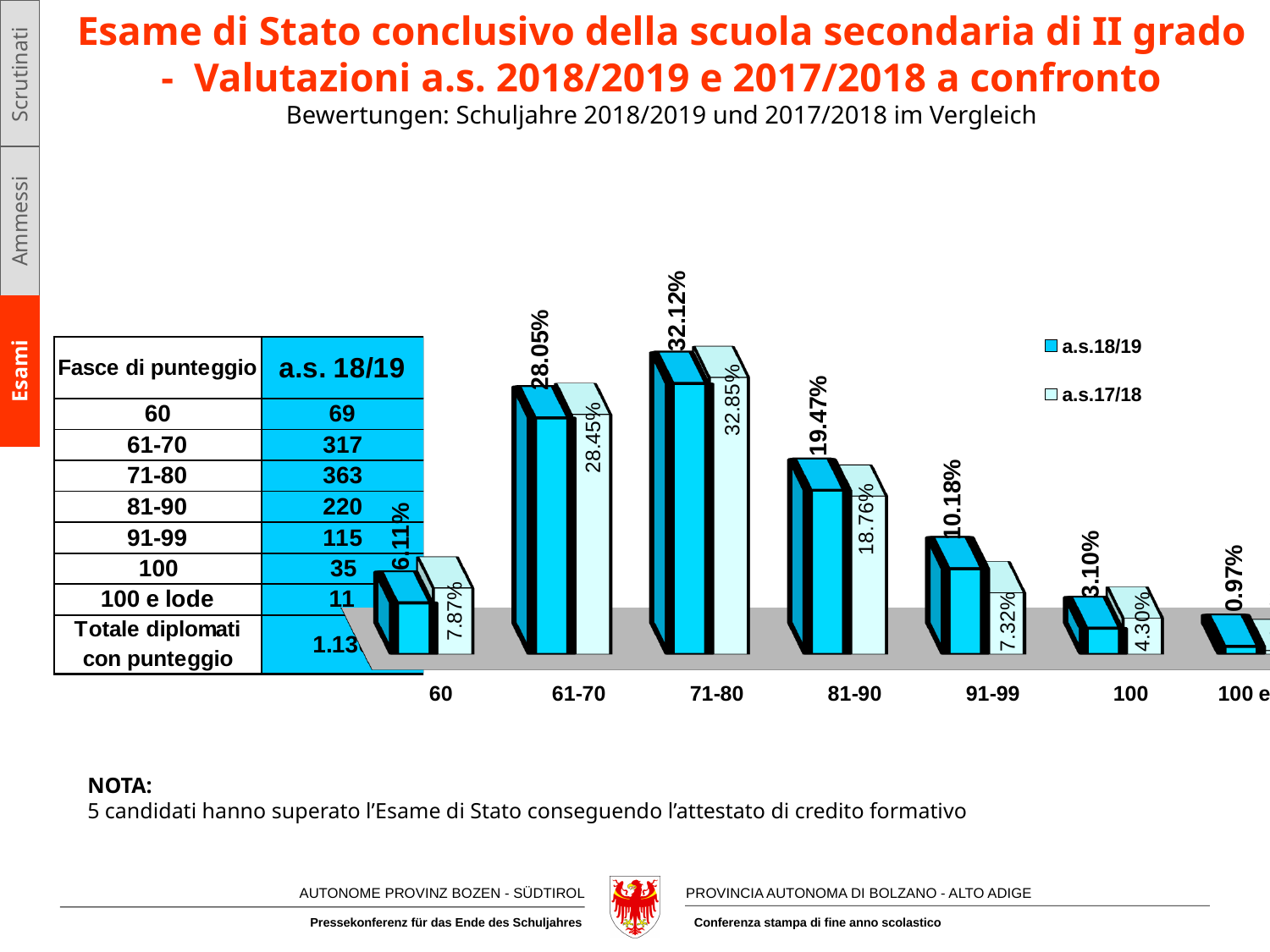
What is the difference between the a.s.18/19 and a.s.17/18 values for the 91-99 score band? 2.86% For the 60 score band, which series has the larger value, a.s.18/19 or a.s.17/18? a.s.17/18 What is the value for the 91-99 score band in the a.s.18/19 series? 10.18% What kind of chart is shown on the slide? bar chart What are the two series names shown in the chart legend? a.s.18/19 and a.s.17/18 What is the value for the 61-70 score band in the a.s.17/18 series? 28.45% For the 81-90 score band, which series has the larger value, a.s.18/19 or a.s.17/18? a.s.18/19 What is the value for the 71-80 score band in the a.s.18/19 series? 32.12% What is the value for the 100 score band in the a.s.17/18 series? 4.30% Which score band has the lowest value in the a.s.17/18 series among those with a printed label? 100 How many series does the chart legend list? 2 Which score band has the highest value in the a.s.18/19 series? 71-80